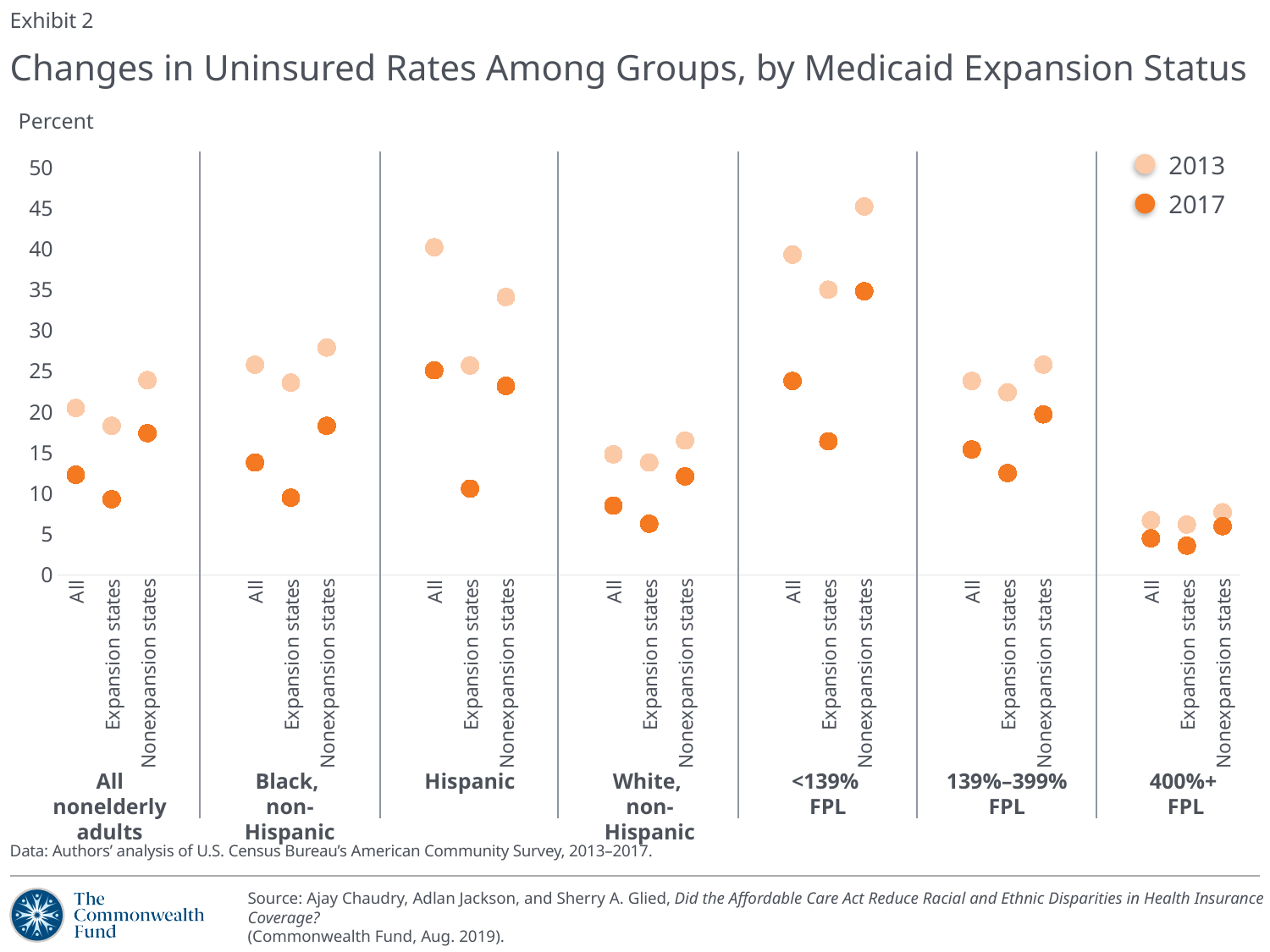
What are the two series named in the legend? 2013 and 2017 Which is larger: the 2013 value for Hispanic, All or the 2013 value for Black, non-Hispanic, All? Hispanic, All How many series does the legend list? 2 Is the 2017 value for All nonelderly adults, All greater or less than 15? less Which group and category has the highest 2013 uninsured rate? Nonexpansion states, <139% FPL Which group has the lowest uninsured rates overall? 400%+ FPL For Black, non-Hispanic, Nonexpansion states, which year has the larger uninsured rate, 2013 or 2017? 2013 How many group panels are shown along the x axis (e.g., All nonelderly adults, Black non-Hispanic, etc.)? 7 Is the 2013 value for Hispanic, All greater or less than 35? greater What kind of chart is shown on the slide? Dot (scatter) chart Is the 2017 value for White, non-Hispanic, Expansion states greater or less than 10? less